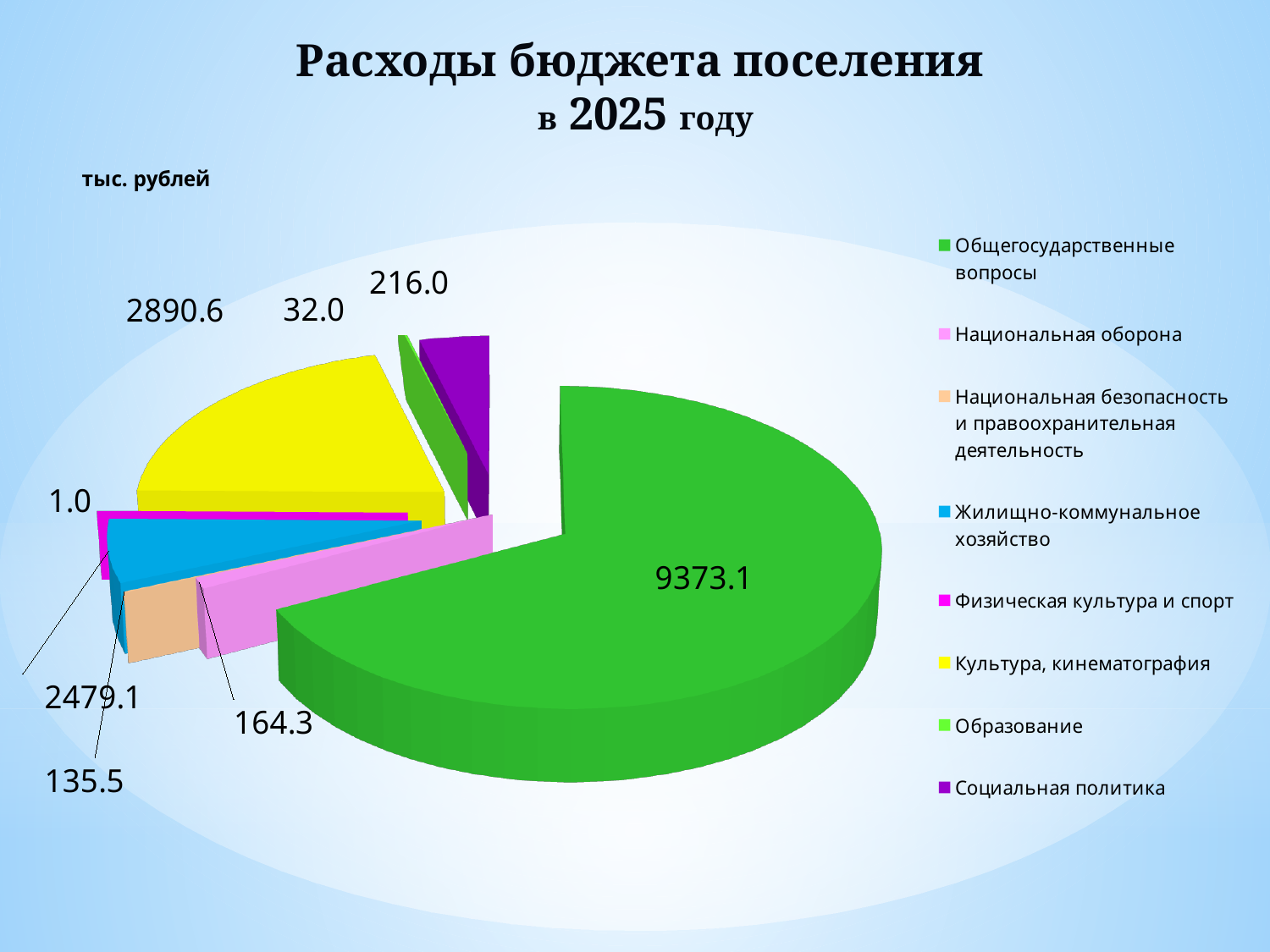
What kind of chart is shown on the slide? Pie chart Which category has the smallest value? Физическая культура и спорт Which category has the largest value? Общегосударственные вопросы What is the value for Социальная политика? 216.0 What unit is indicated for the values on the chart? тыс. рублей What is the value for Образование? 32.0 Which is larger: Национальная оборона or Национальная безопасность и правоохранительная деятельность? Национальная оборона What is the value for Общегосударственные вопросы? 9373.1 What is the value for Жилищно-коммунальное хозяйство? 2479.1 What is the value for Культура, кинематография? 2890.6 What is the difference between Культура, кинематография and Жилищно-коммунальное хозяйство? 411.5 How many categories does the legend list? 8